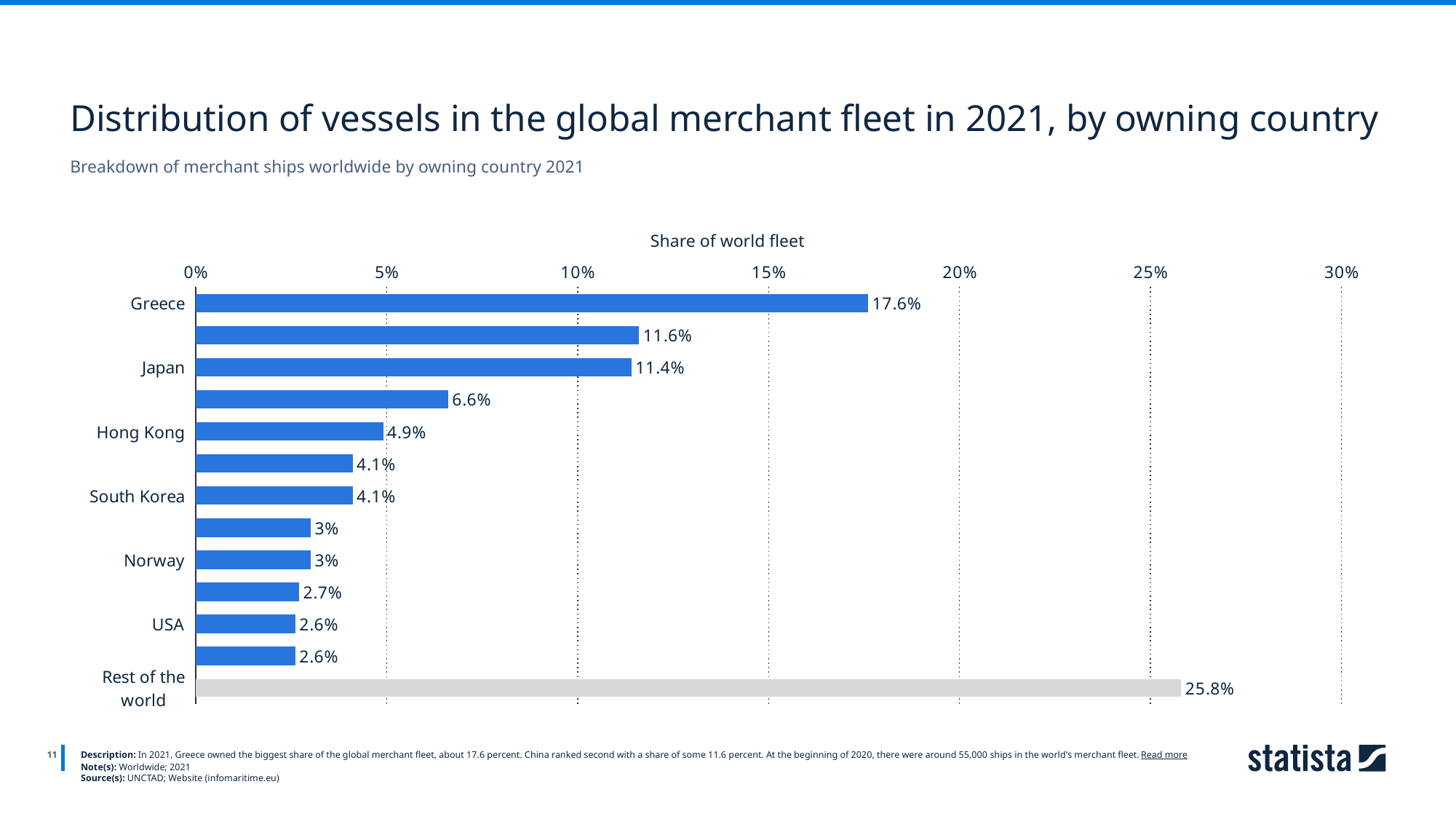
What share of the world fleet is shown for Norway? 3% What share of the world fleet is shown for Hong Kong? 4.9% What type of chart is shown on the slide? Bar chart What share of the world fleet is shown for Greece? 17.6% How many bars are plotted in the chart? 13 What share of the world fleet is shown for the USA? 2.6% Excluding Rest of the world, which named country has the largest share of the world fleet? Greece Which has a larger share of the world fleet, Hong Kong or South Korea? Hong Kong What share of the world fleet is shown for Rest of the world? 25.8% What share of the world fleet is shown for South Korea? 4.1% What is the difference in percentage points between Greece's share and Japan's share? 6.2 percentage points What share of the world fleet is shown for Japan? 11.4%